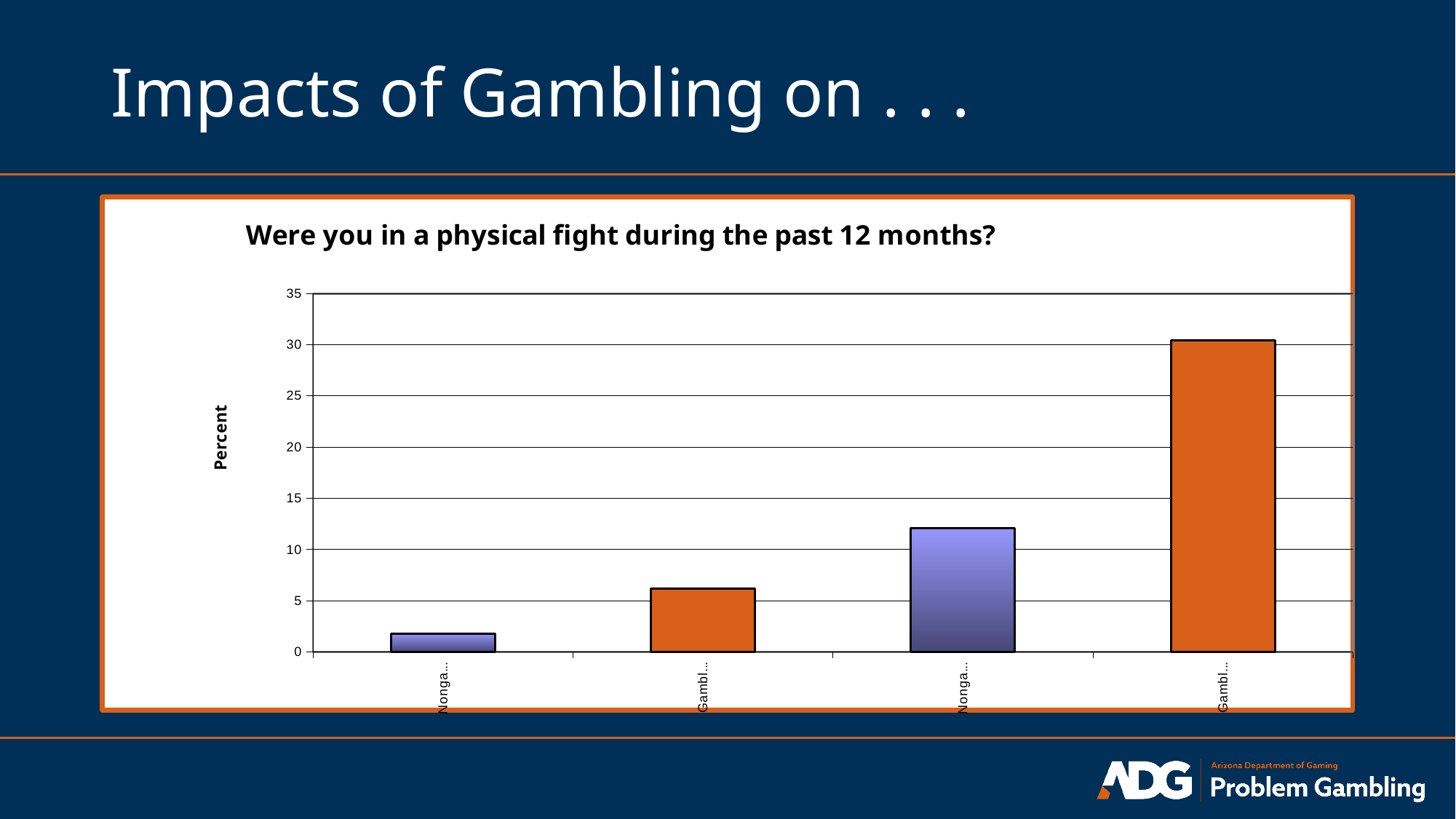
Which bar is the shortest in the chart? the first (leftmost) bar Which bar is the tallest in the chart? the fourth (rightmost) bar Which is larger, the value of the second bar or the value of the third bar? the third bar What kind of chart is shown on the slide? bar chart Is the value for the third bar from the left greater or less than 10? greater What is the label on the vertical axis of the chart? Percent Do the bar values rise or fall from left to right across the chart? rise How many bars are plotted in the chart? 4 Is the value for the second bar from the left greater or less than 10? less What is the title of the chart? Were you in a physical fight during the past 12 months? Is the value for the leftmost bar greater or less than 5? less